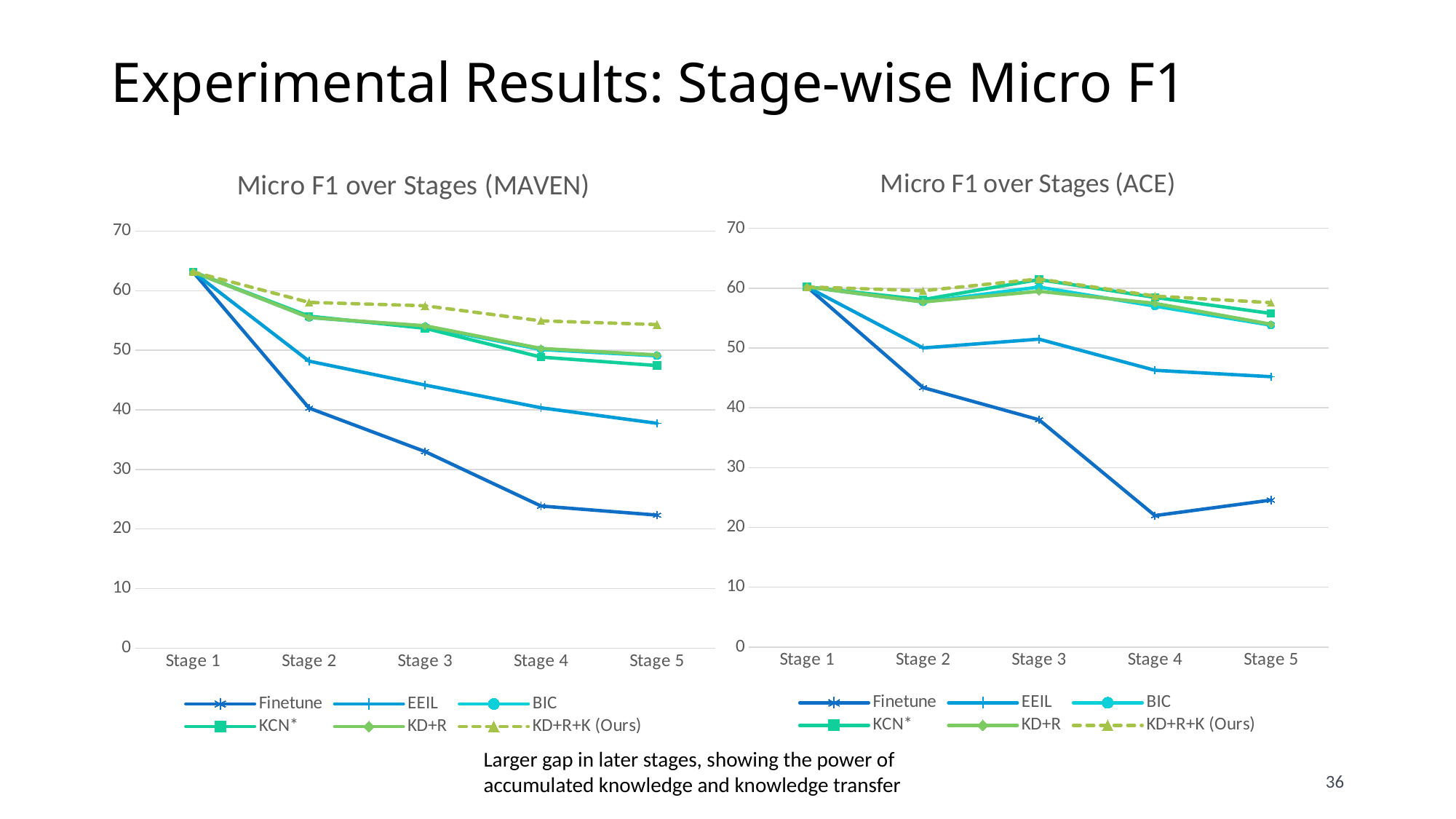
In the Micro F1 over Stages (MAVEN) chart, is the value for Finetune at Stage 5 greater or less than 30? less In the Micro F1 over Stages (MAVEN) chart, is the value for KD+R+K (Ours) at Stage 5 greater or less than 50? greater How many series does the legend of the Micro F1 over Stages (ACE) chart list? 6 In the Micro F1 over Stages (MAVEN) chart, which series has the lowest value at Stage 5? Finetune In the Micro F1 over Stages (MAVEN) chart, does the Finetune series rise or fall from Stage 1 to Stage 5? fall In the Micro F1 over Stages (ACE) chart, which series has the lowest value at Stage 5? Finetune In the Micro F1 over Stages (ACE) chart, is the value for EEIL at Stage 5 greater or less than 40? greater In the Micro F1 over Stages (ACE) chart, at Stage 2, which is larger: EEIL or Finetune? EEIL In the Micro F1 over Stages (MAVEN) chart, which series has the highest value at Stage 5? KD+R+K (Ours) What type of chart is the Micro F1 over Stages (MAVEN) chart? line chart How many stages are shown on the x axis of the Micro F1 over Stages (MAVEN) chart? 5